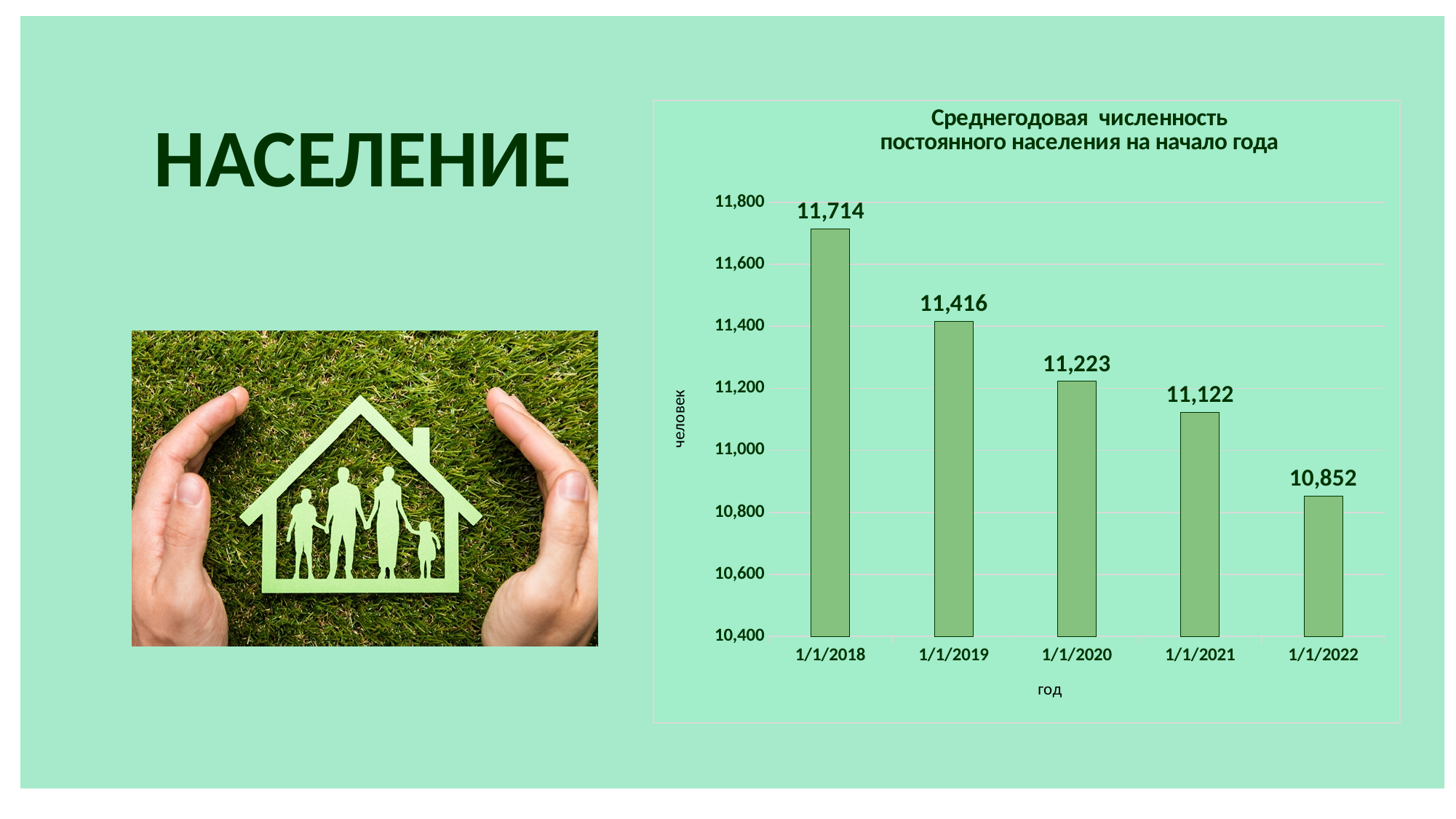
How many years are shown on the x axis? 5 What is the value for 1/1/2020? 11,223 What is the difference between the values for 1/1/2018 and 1/1/2019? 298 Is the value for 1/1/2022 greater or less than 11,000? less Which is larger, the value for 1/1/2019 or the value for 1/1/2021? 1/1/2019 What kind of chart is shown? bar chart Do the values rise or fall from 1/1/2018 to 1/1/2022? fall Which year has the lowest value? 1/1/2022 What is the value for 1/1/2018? 11,714 What is the difference between the values for 1/1/2021 and 1/1/2022? 270 What is the value for 1/1/2022? 10,852 Which year has the highest value? 1/1/2018